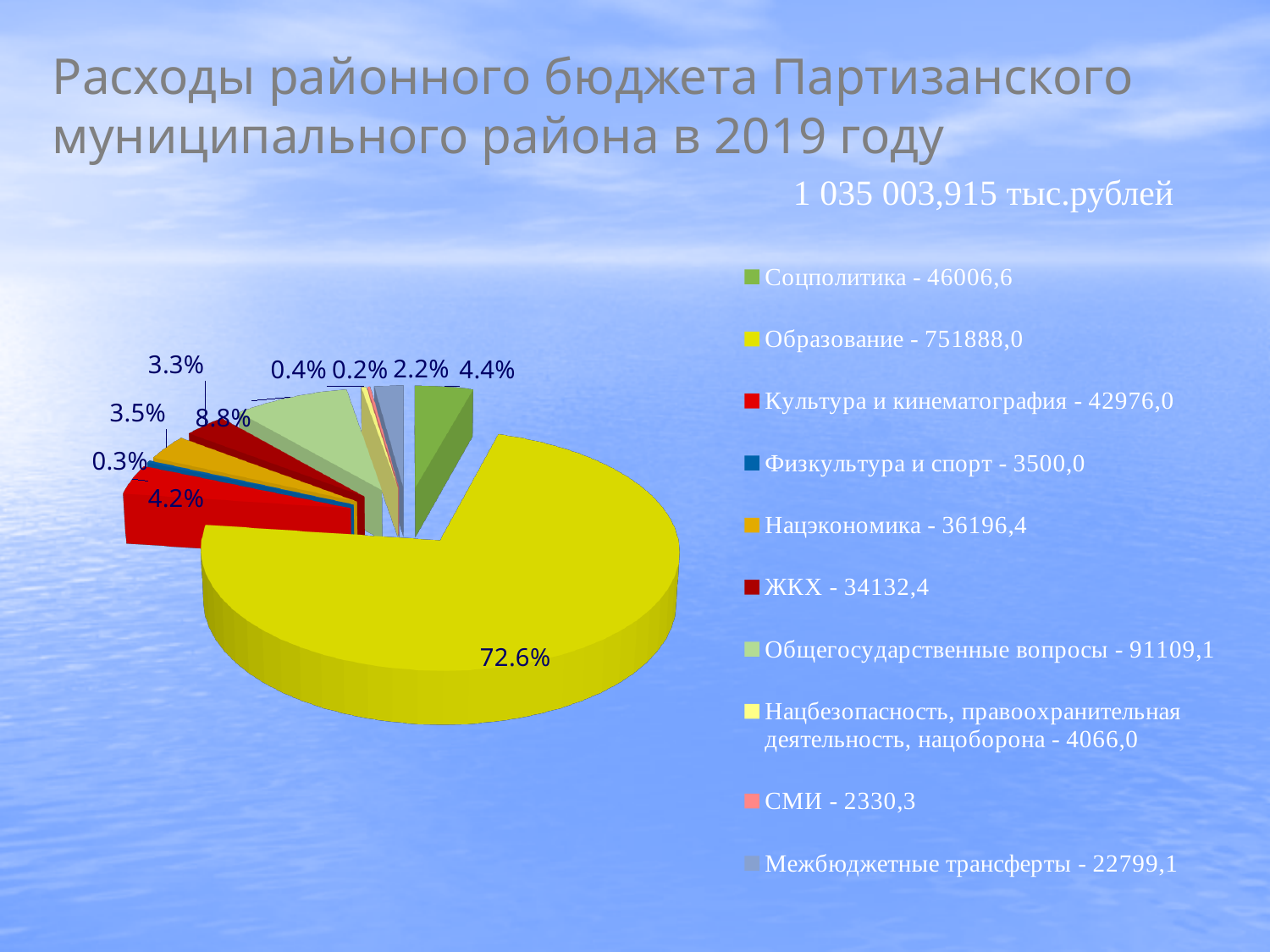
What percentage share of the pie does Образование have? 72.6% How many categories does the legend of the pie chart list? 10 What is the value shown in the legend for Соцполитика? 46006,6 What is the value shown in the legend for СМИ? 2330,3 What is the value shown in the legend for ЖКХ? 34132,4 What percentage share of the pie does Общегосударственные вопросы have? 8.8% Which category has the largest share of the pie? Образование What is the value shown in the legend for Образование? 751888,0 What is the difference between the legend values for Соцполитика and Культура и кинематография? 3030,6 Which category has the smallest share of the pie? СМИ What type of chart is shown on the slide? Pie chart Which is larger, the value for Нацэкономика or the value for ЖКХ? Нацэкономика